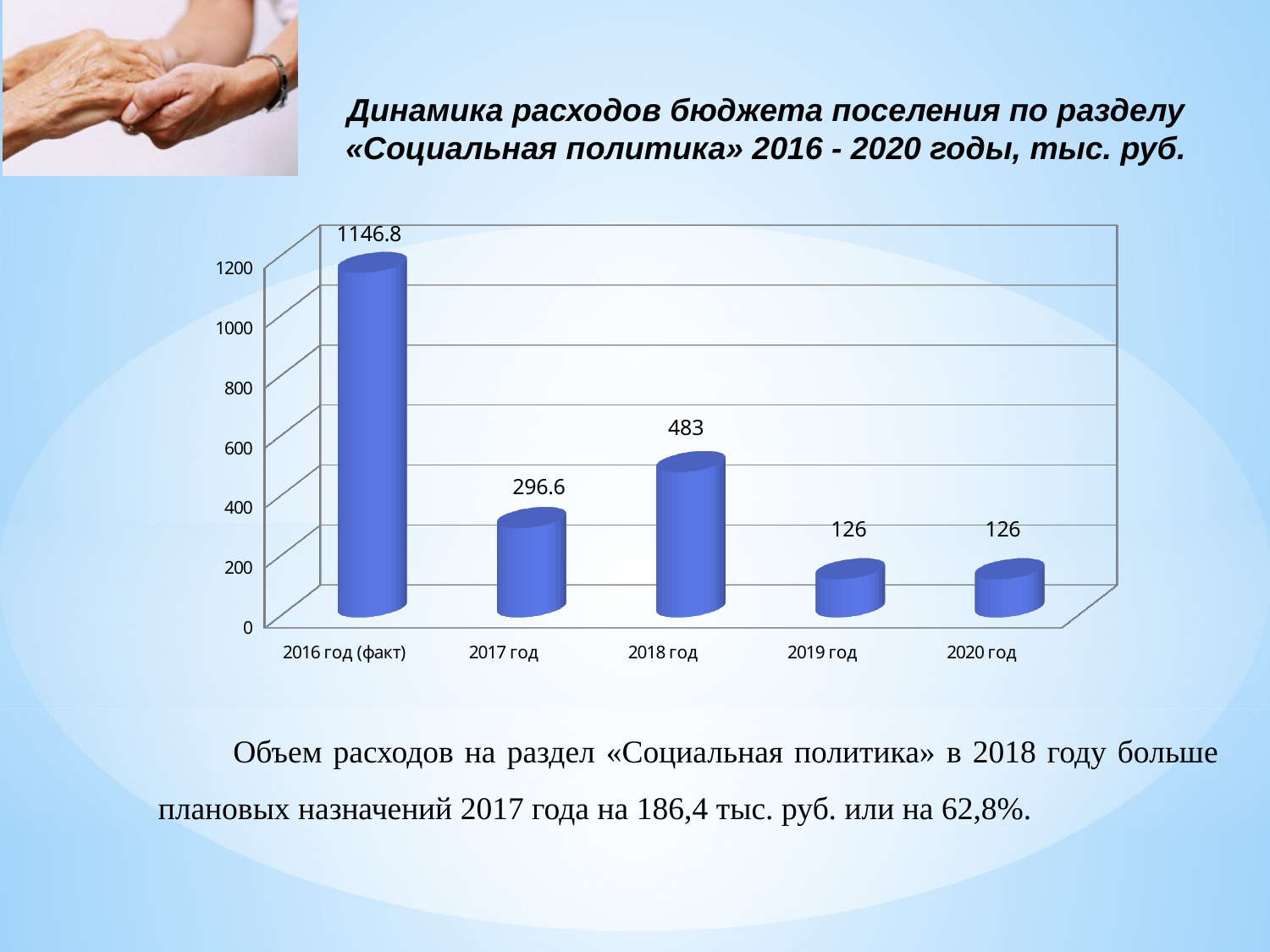
What is the value for 2020 год? 126 Do the values rise or fall from 2018 год to 2020 год? Fall What is the value for 2017 год? 296.6 How many years (categories) are shown on the chart? 5 What is the difference between the values for 2018 год and 2017 год? 186.4 Which two years share the lowest value? 2019 год and 2020 год What is the difference between the values for 2016 год (факт) and 2017 год? 850.2 What kind of chart is shown on the slide? Bar chart What is the value for 2016 год (факт)? 1146.8 Which is larger, the value for 2017 год or the value for 2018 год? 2018 год What is the value for 2018 год? 483 Which year has the highest value? 2016 год (факт)